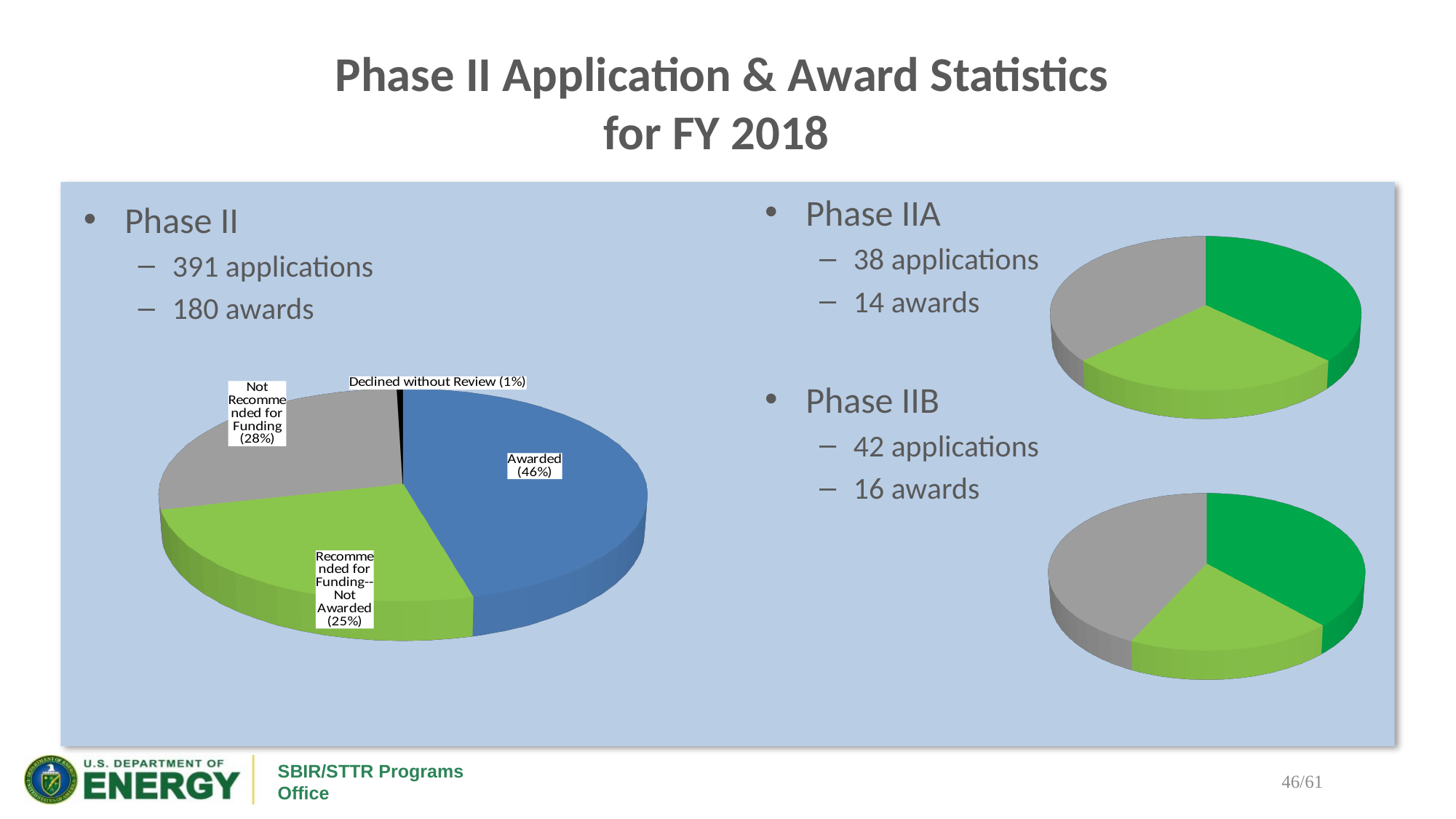
In the Phase II pie chart on the left, what colour is the Awarded slice? Blue In the Phase II pie chart on the left, which is larger: the Not Recommended for Funding share or the Recommended for Funding--Not Awarded share? Not Recommended for Funding In the Phase II pie chart on the left, what share of applications were Recommended for Funding--Not Awarded? 25% In the Phase II pie chart on the left, which category has the largest share? Awarded What type of chart is used for the Phase II data on the left of the slide? Pie chart How many categories are shown in the Phase II pie chart on the left? 4 In the Phase II pie chart on the left, what is the difference in percentage points between the Awarded share and the Not Recommended for Funding share? 18 How many pie charts are shown on the slide? 3 In the Phase II pie chart on the left, what share of applications were Awarded? 46% In the Phase II pie chart on the left, what share of applications were Not Recommended for Funding? 28% In the Phase II pie chart on the left, what share of applications were Declined without Review? 1% In the Phase II pie chart on the left, which category has the smallest share? Declined without Review